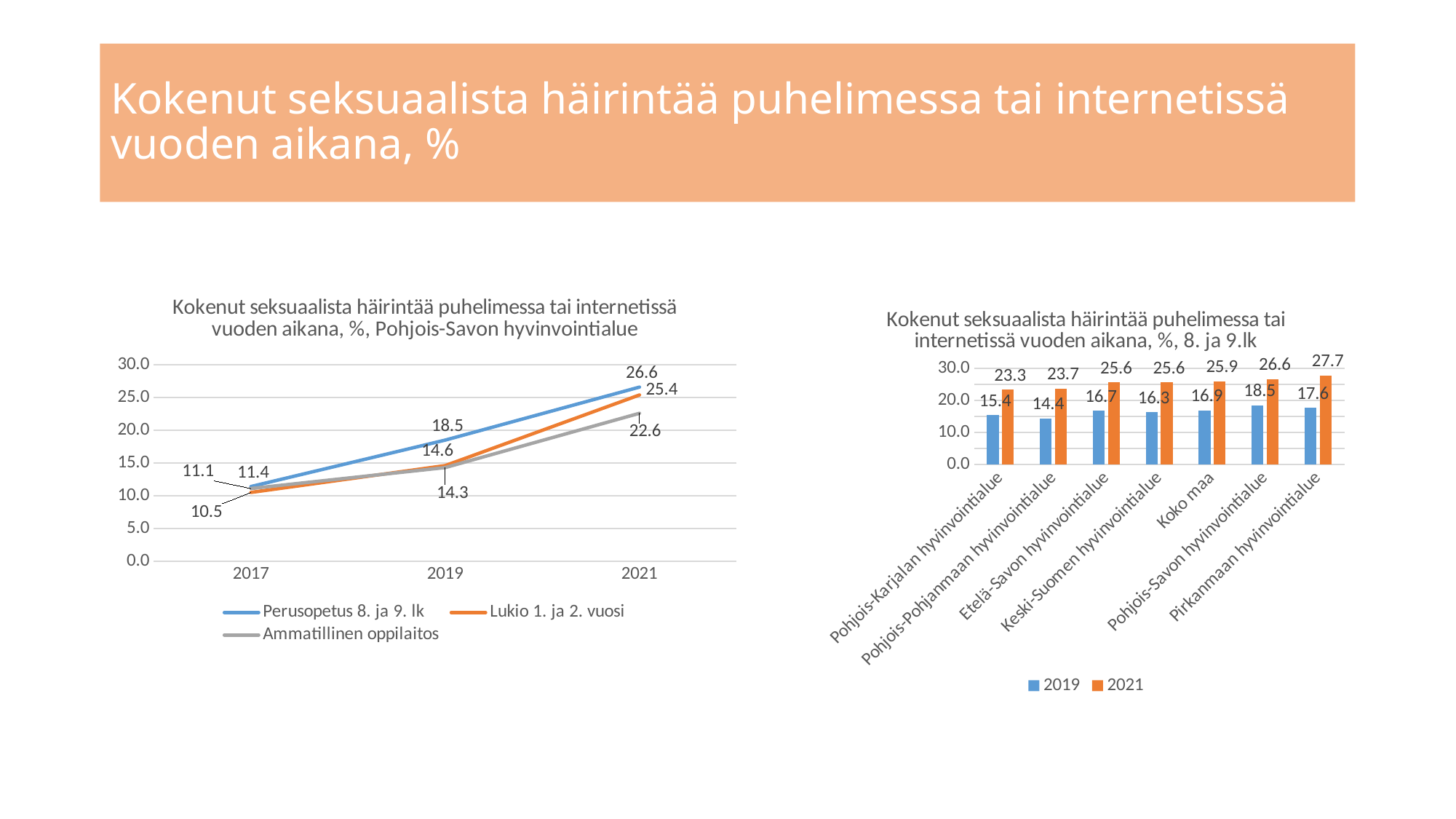
In the left chart (Pohjois-Savon hyvinvointialue), what kind of chart is it? Line chart In the left chart (Pohjois-Savon hyvinvointialue), what is the value for Perusopetus 8. ja 9. lk in 2021? 26.6 In the right chart (8. ja 9.lk), what is the 2019 value for Koko maa? 16.9 In the left chart (Pohjois-Savon hyvinvointialue), what is the value for Lukio 1. ja 2. vuosi in 2019? 14.6 In the left chart (Pohjois-Savon hyvinvointialue), does the value for Perusopetus 8. ja 9. lk rise or fall from 2017 to 2021? Rise In the right chart (8. ja 9.lk), which region has the lowest 2019 value? Pohjois-Pohjanmaan hyvinvointialue In the left chart (Pohjois-Savon hyvinvointialue), how many series does the legend list? 3 In the left chart (Pohjois-Savon hyvinvointialue), what is the difference between Perusopetus 8. ja 9. lk and Ammatillinen oppilaitos in 2021? 4.0 In the right chart (8. ja 9.lk), what is the 2021 value for Pirkanmaan hyvinvointialue? 27.7 In the left chart (Pohjois-Savon hyvinvointialue), what is the value for Ammatillinen oppilaitos in 2021? 22.6 In the right chart (8. ja 9.lk), how many regions are shown on the x axis? 7 In the right chart (8. ja 9.lk), which region has the highest 2021 value? Pirkanmaan hyvinvointialue